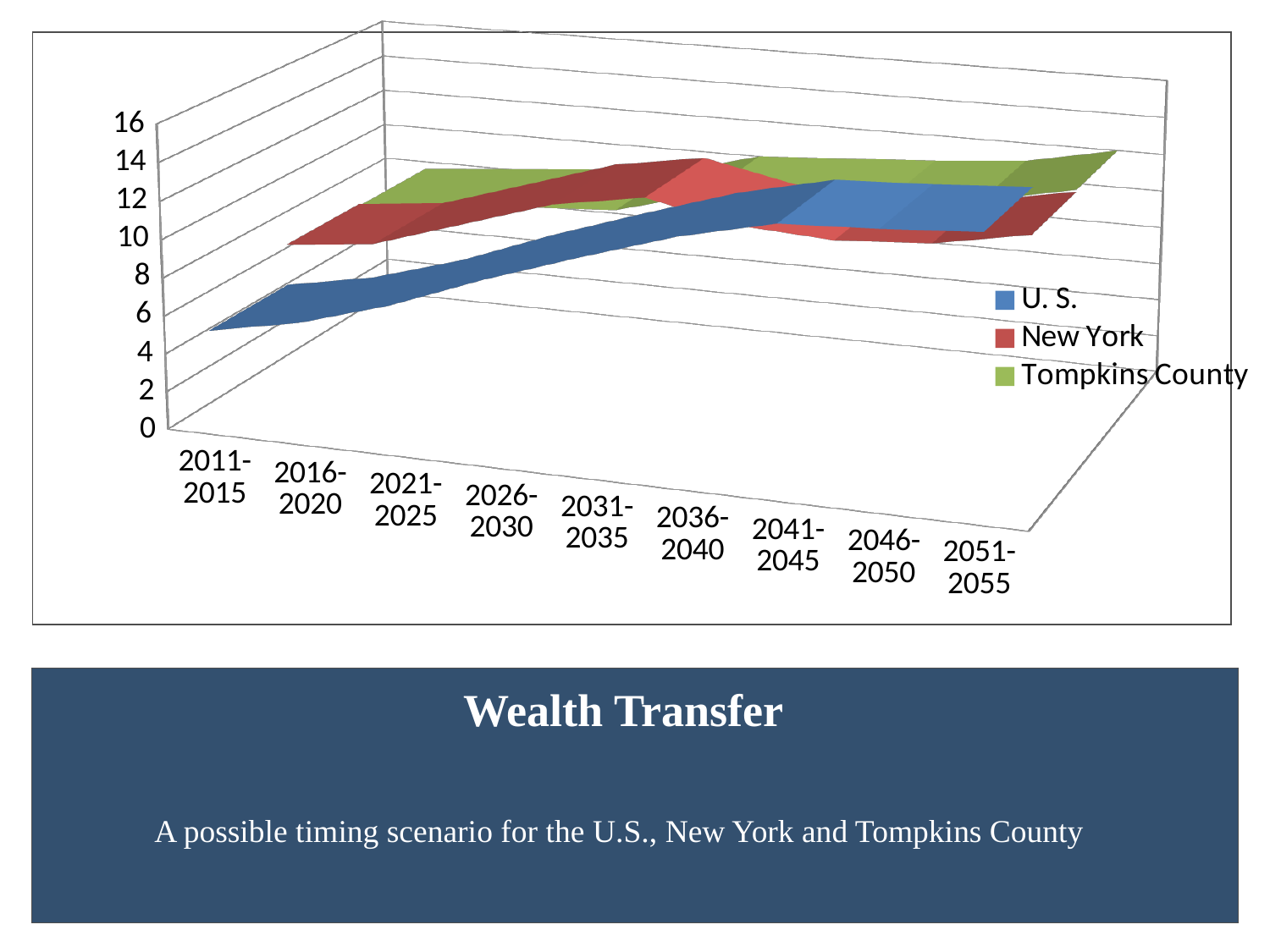
What is the highest tick value on the vertical axis? 16 Which series is shown in green? Tompkins County What is the last time period on the x axis? 2051-2055 How many time periods are shown along the x axis? 9 Does the U. S. series generally rise or fall from 2011-2015 to 2041-2045? rise Is the U. S. value for 2011-2015 greater or less than 10? less How many series does the legend list? 3 What kind of chart is shown on the slide? 3D line chart